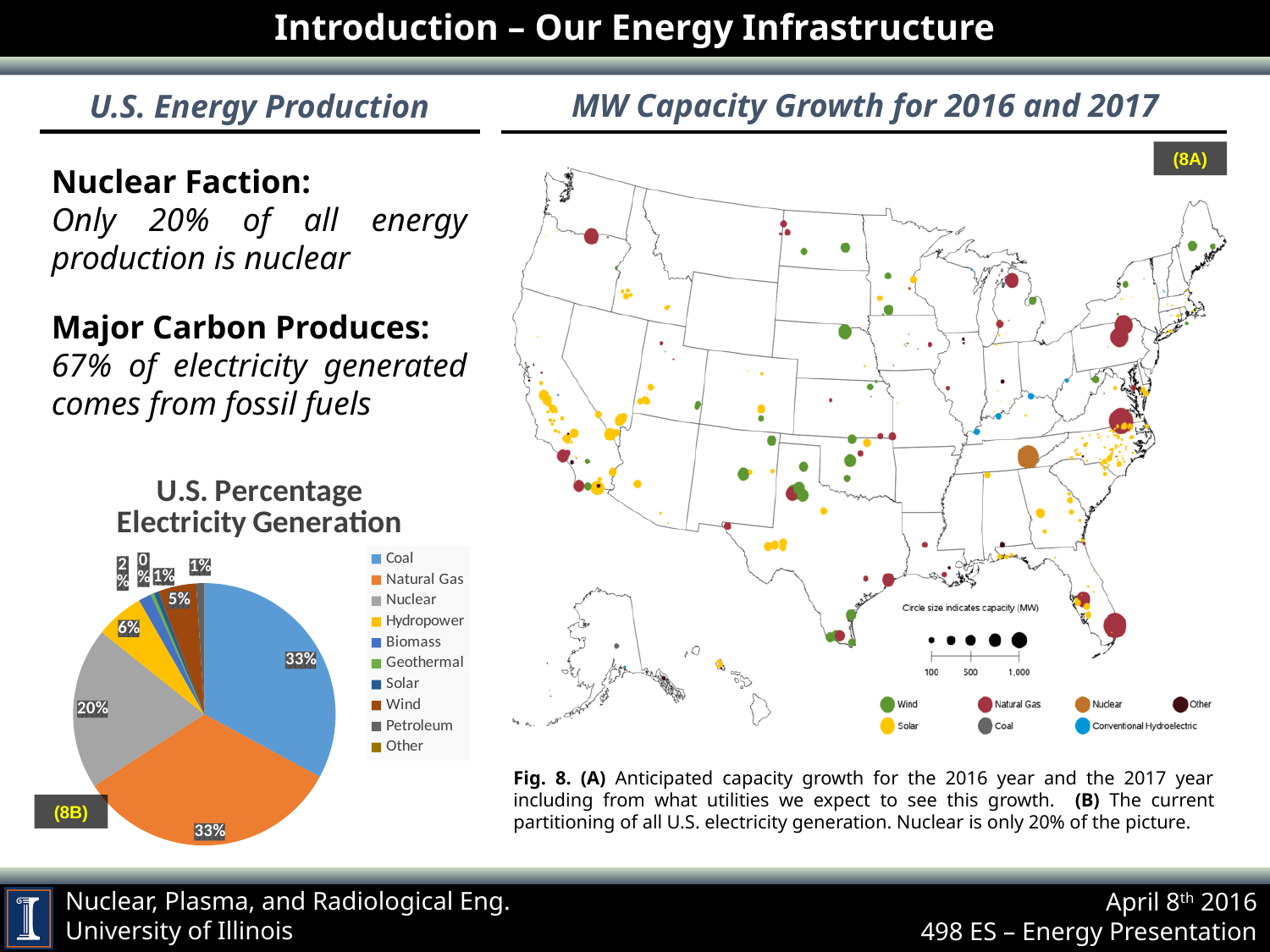
How many categories does the legend of the U.S. Percentage Electricity Generation chart list? 10 In the U.S. Percentage Electricity Generation pie chart, what percentage is shown for Nuclear? 20% In the U.S. Percentage Electricity Generation pie chart, which is larger, Nuclear or Wind? Nuclear In the U.S. Percentage Electricity Generation pie chart, what percentage is shown for Natural Gas? 33% In the U.S. Percentage Electricity Generation pie chart, what percentage is shown for Wind? 5% In the U.S. Percentage Electricity Generation pie chart, what percentage is shown for Coal? 33% In the U.S. Percentage Electricity Generation pie chart, which is larger, Hydropower or Wind? Hydropower What kind of chart is the U.S. Percentage Electricity Generation chart? Pie chart In the U.S. Percentage Electricity Generation pie chart, what percentage is shown for Hydropower? 6% What is the title of the pie chart on the left side of the slide? U.S. Percentage Electricity Generation In the U.S. Percentage Electricity Generation pie chart, what is the difference between the Coal and Nuclear percentages? 13% In the U.S. Percentage Electricity Generation pie chart, what is the difference between the Nuclear and Hydropower percentages? 14%